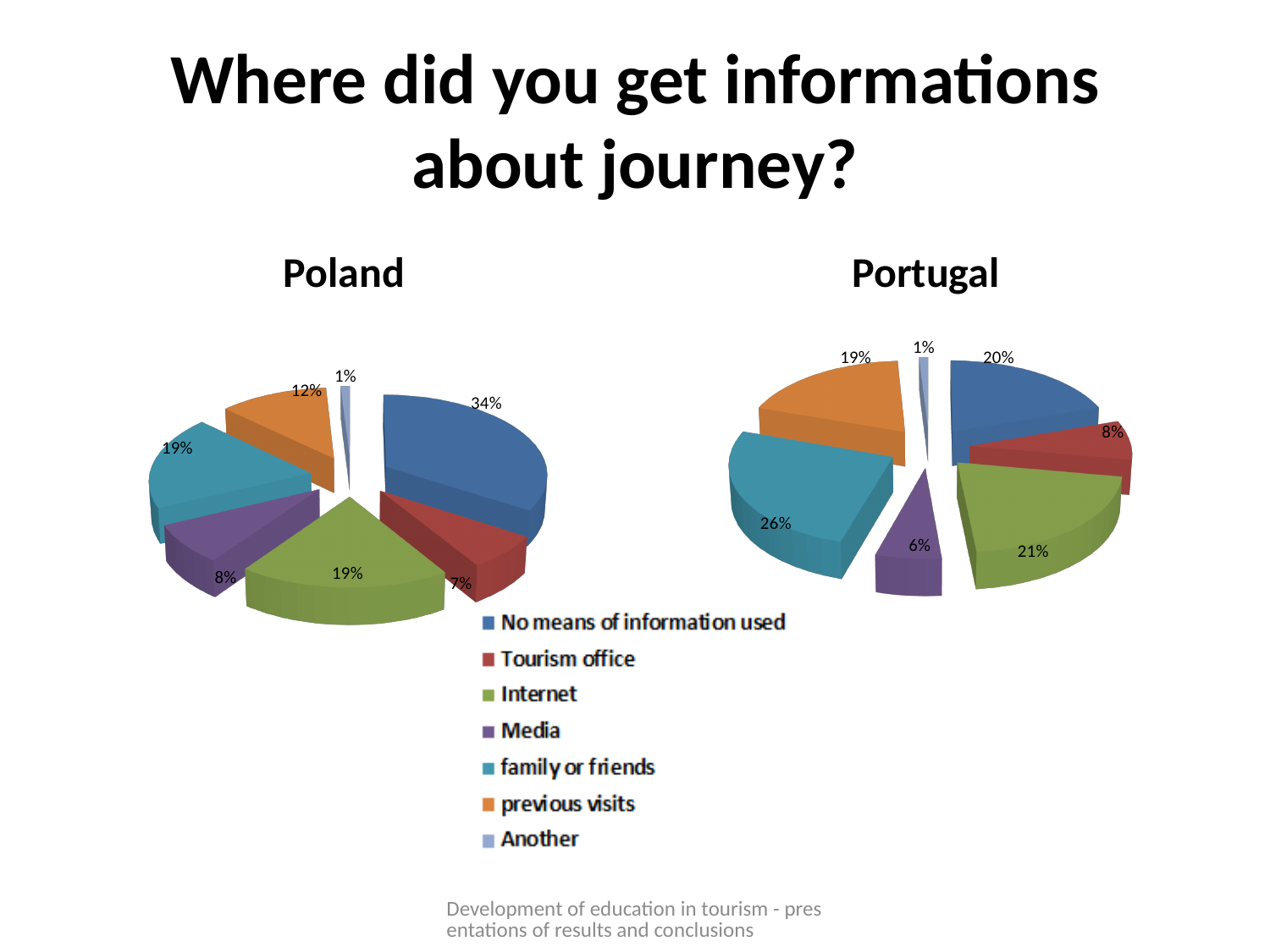
In the Portugal chart, what is the difference between the share for family or friends and the share for Media? 20% In the Portugal chart, what share of respondents got information from family or friends? 26% In the Poland chart, which source of information has the smallest share? Another In the Poland chart, what share of respondents used no means of information? 34% In the Portugal chart, which source of information has the largest share? family or friends In the Portugal chart, what share of respondents got information from the Internet? 21% Which chart shows a larger share for Tourism office, Poland or Portugal? Portugal What type of chart is used for Poland and Portugal? Pie chart How many categories does the legend list for the pie charts? 7 Which colour represents Media in the legend? Purple In the Poland chart, what share of respondents got information from previous visits? 12% In the Poland chart, what is the difference between the share for no means of information used and the share for the Internet? 15%